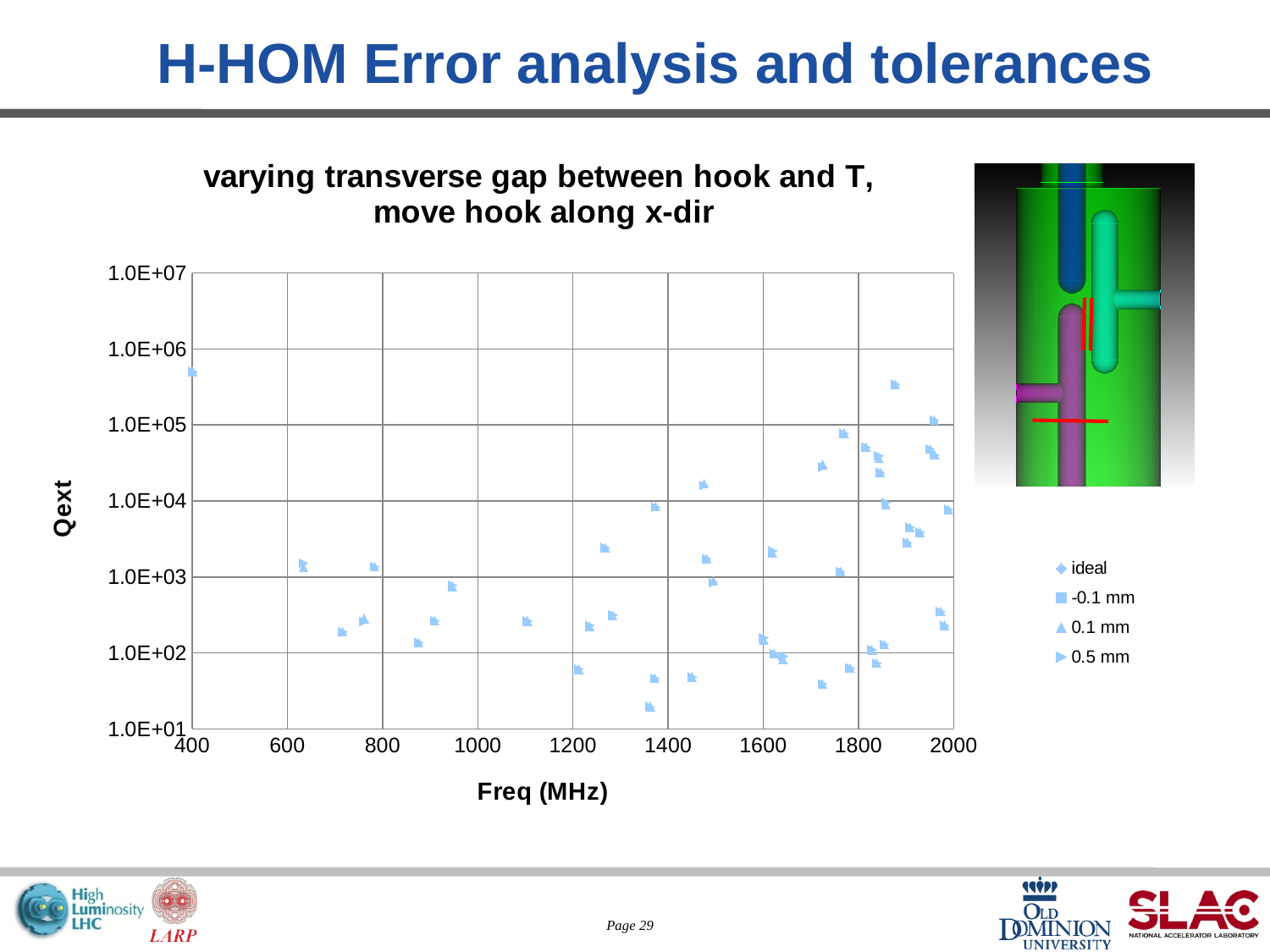
Is the Qext value of the lowest point plotted near 1360 MHz greater or less than 1.0E+02? less What is the highest frequency value shown on the x axis of the chart? 2000 What is the title of the chart? varying transverse gap between hook and T, move hook along x-dir How many series does the chart legend list? 4 What is the label of the x axis of the chart? Freq (MHz) Is the Qext value of the highest point plotted near 1880 MHz greater or less than 1.0E+05? greater Is the Qext value of the point plotted near 400 MHz greater or less than 1.0E+05? greater What kind of chart is shown on the slide? Scatter chart